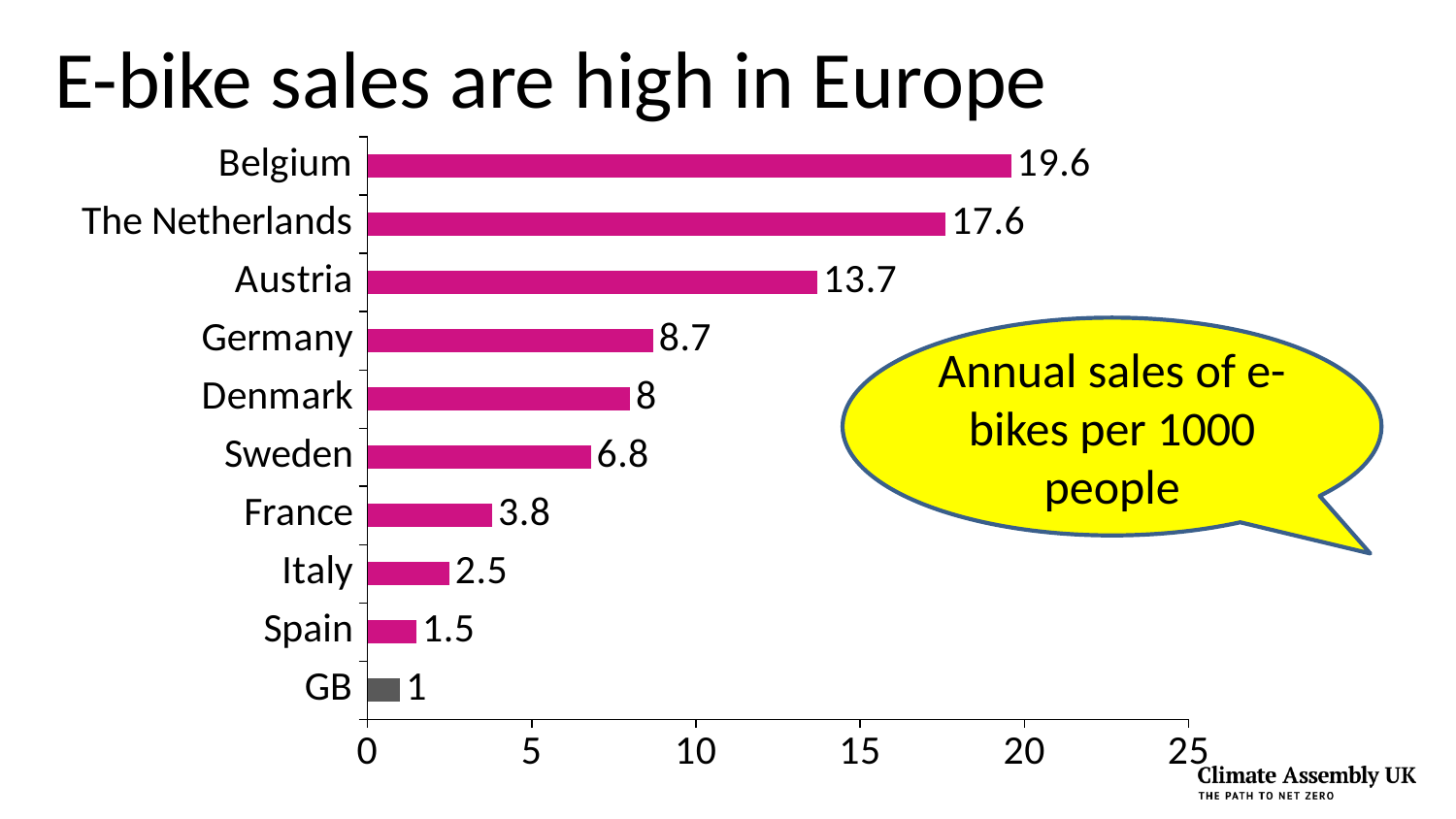
Which is larger, the value for Sweden or the value for France? Sweden What kind of chart is shown on the slide? Bar chart What is the value for Belgium? 19.6 How many countries are shown in the chart? 10 What is the value for GB? 1 What is the value for Germany? 8.7 What is the difference between the values for Belgium and The Netherlands? 2 Which country's bar is coloured grey rather than pink? GB Which country has the lowest value? GB Is the value for Austria greater or less than 10? greater What is the difference between the values for Austria and Germany? 5 Which country has the highest value? Belgium